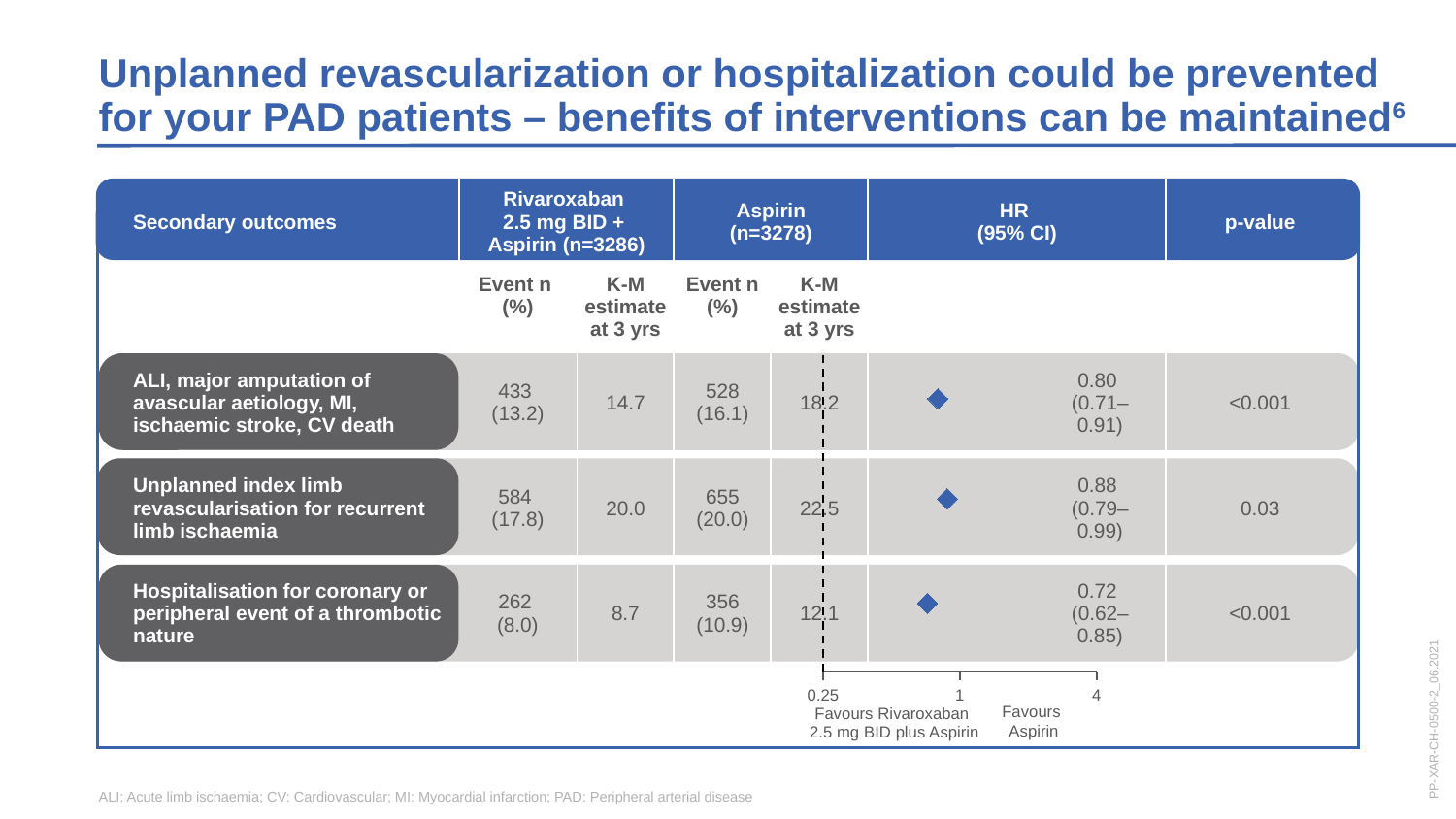
Which secondary outcome has the highest hazard ratio in the forest plot? Unplanned index limb revascularisation for recurrent limb ischaemia What is the difference between the hazard ratios for unplanned index limb revascularisation and hospitalisation for a thrombotic event? 0.16 What is the hazard ratio for unplanned index limb revascularisation for recurrent limb ischaemia? 0.88 Which side of the forest plot axis favours Aspirin? Right What is the p-value for unplanned index limb revascularisation for recurrent limb ischaemia? 0.03 What is the 95% CI for the hazard ratio of ALI, major amputation of avascular aetiology, MI, ischaemic stroke, CV death? 0.71–0.91 What are the tick values shown on the hazard ratio axis? 0.25, 1, 4 How many secondary outcomes are plotted in the forest plot? 3 Which has the larger hazard ratio: ALI, major amputation, MI, ischaemic stroke, CV death or unplanned index limb revascularisation? Unplanned index limb revascularisation Which secondary outcome has the lowest hazard ratio in the forest plot? Hospitalisation for coronary or peripheral event of a thrombotic nature Is the hazard ratio for ALI, major amputation, MI, ischaemic stroke, CV death greater or less than 1? less What is the hazard ratio for hospitalisation for coronary or peripheral event of a thrombotic nature? 0.72